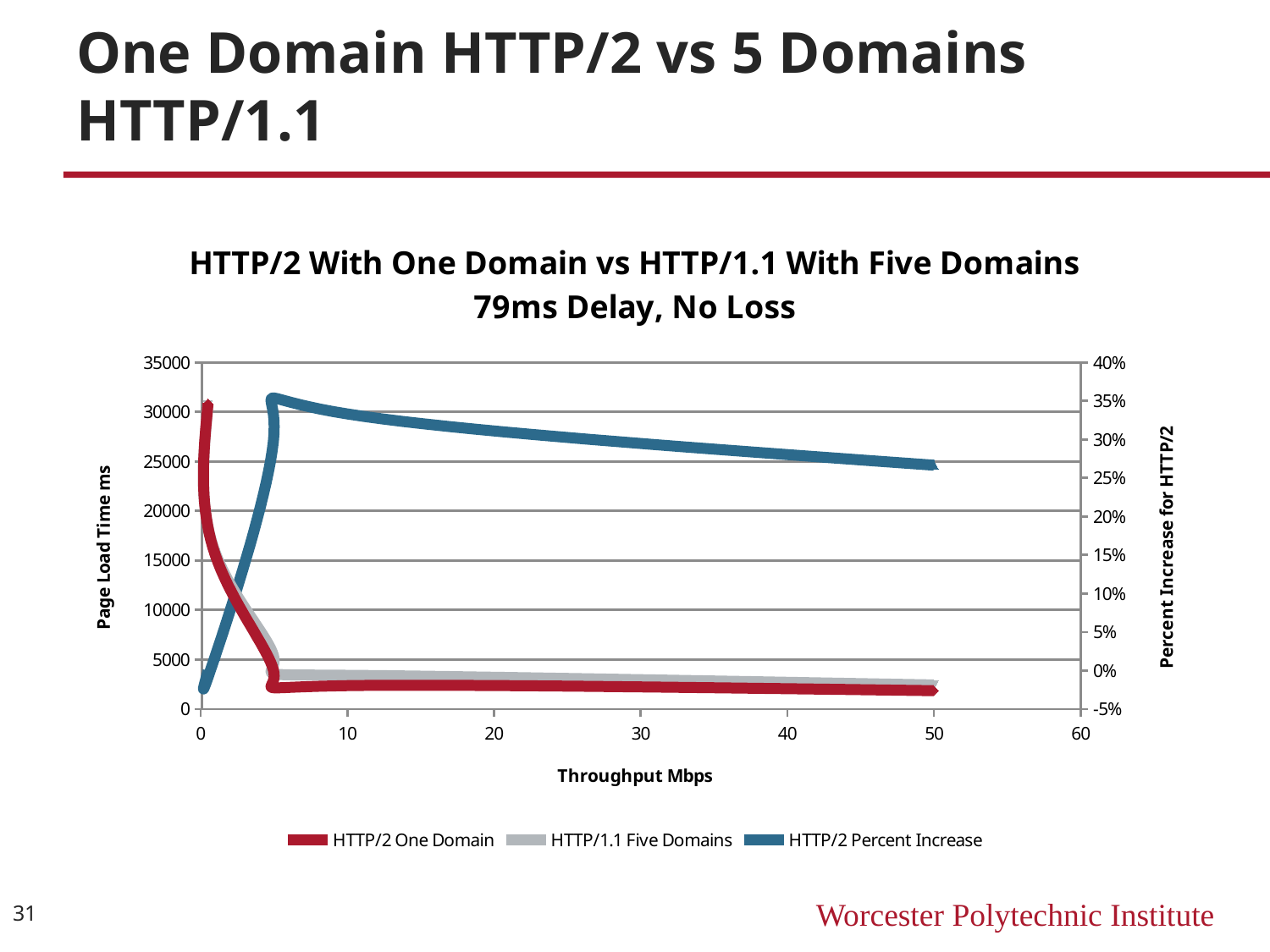
Is the page load time for HTTP/2 One Domain at 50 Mbps greater or less than 5000 ms? less Is the page load time for HTTP/1.1 Five Domains at 50 Mbps greater or less than 5000 ms? less Is the page load time for HTTP/2 One Domain at the lowest throughput greater or less than 25000 ms? greater How many series does the legend list? 3 What kind of chart is shown on the slide? line chart After its peak near 5 Mbps, does HTTP/2 Percent Increase rise or fall as throughput increases? fall What is the title of the chart? HTTP/2 With One Domain vs HTTP/1.1 With Five Domains 79ms Delay, No Loss At 50 Mbps, which series has the higher page load time, HTTP/2 One Domain or HTTP/1.1 Five Domains? HTTP/1.1 Five Domains What is the label of the x axis? Throughput Mbps Does the page load time for HTTP/2 One Domain rise or fall as throughput increases? fall